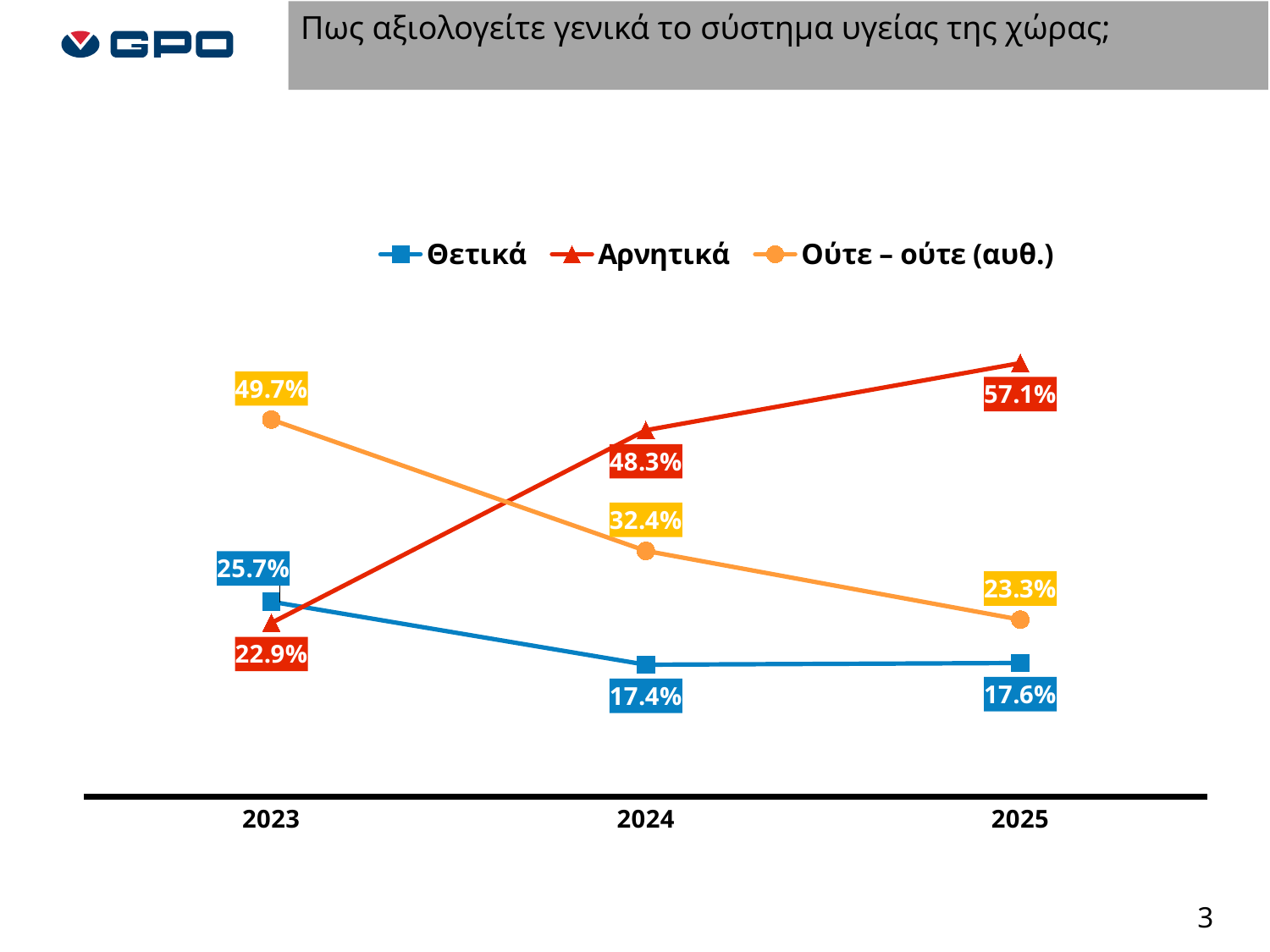
Which is larger in 2023: Ούτε – ούτε (αυθ.) or Αρνητικά? Ούτε – ούτε (αυθ.) How many years are shown on the x axis? 3 In which year is the Αρνητικά series highest? 2025 How many series does the legend list? 3 What is the value for Αρνητικά in 2025? 57.1% What is the value for Θετικά in 2023? 25.7% What colour is the line for the Αρνητικά series? Red What is the value for Ούτε – ούτε (αυθ.) in 2024? 32.4% Does the Ούτε – ούτε (αυθ.) series rise or fall from 2023 to 2025? Fall What kind of chart is shown on the slide? Line chart What is the difference between the Αρνητικά value in 2025 and in 2023? 34.2% In which year is the Θετικά series lowest? 2024